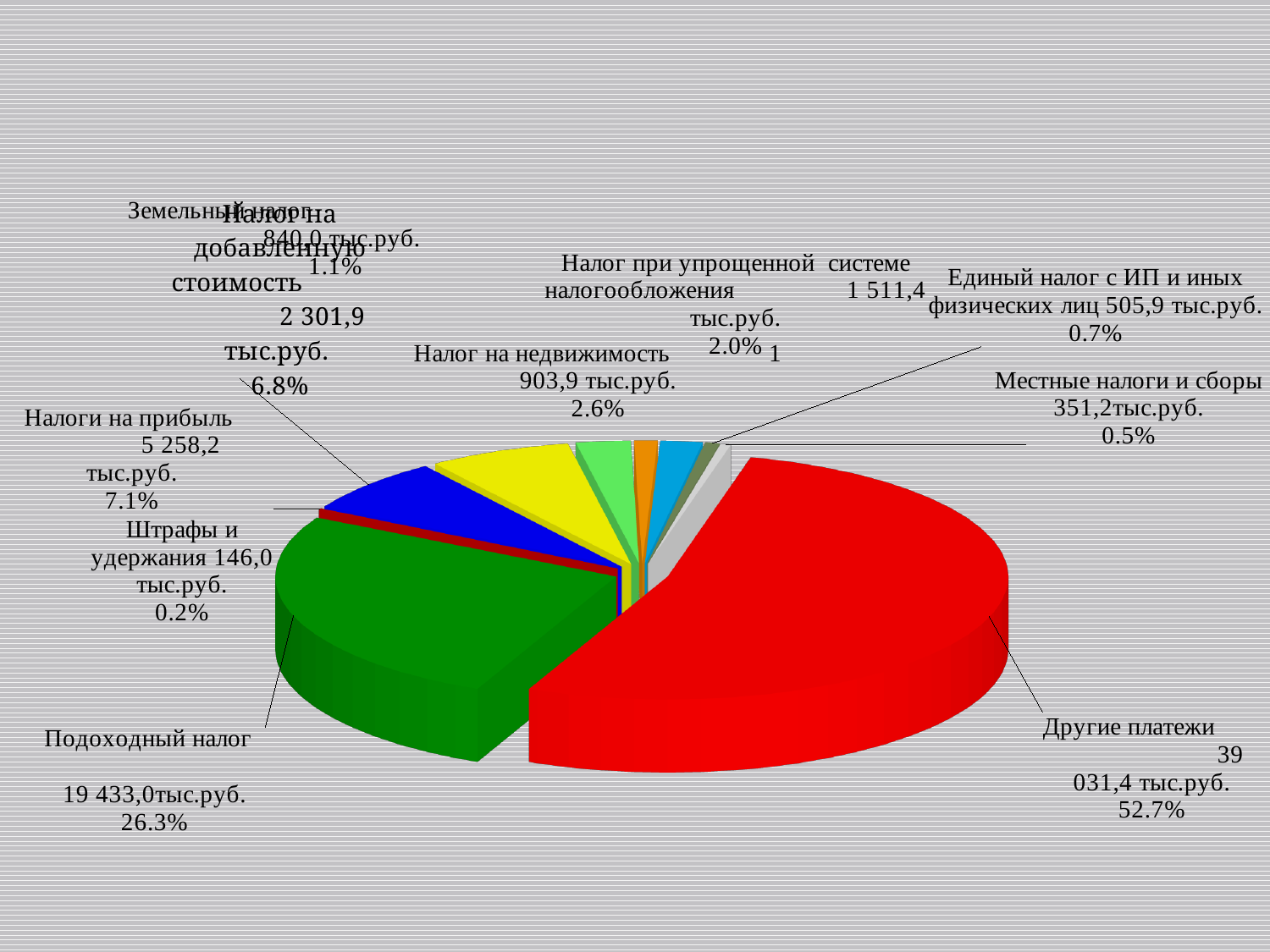
What is the value shown for Налог на недвижимость? 1 903,9 тыс.руб. What is the difference in percentage points between the shares of Другие платежи and Подоходный налог? 26.4% What share of the pie does Подоходный налог account for? 26.3% Which category has the largest slice of the pie? Другие платежи How many categories (slices) does the pie chart have? 10 What is the value shown for Налоги на прибыль? 5 258,2 тыс.руб. What colour is the slice for Другие платежи? red Which has the larger share: Налоги на прибыль or Налог на добавленную стоимость? Налоги на прибыль Which category has the smallest share of the pie? Штрафы и удержания What percentage is shown for Другие платежи? 52.7% What percentage is shown for Местные налоги и сборы? 0.5% What kind of chart is shown on the slide? pie chart